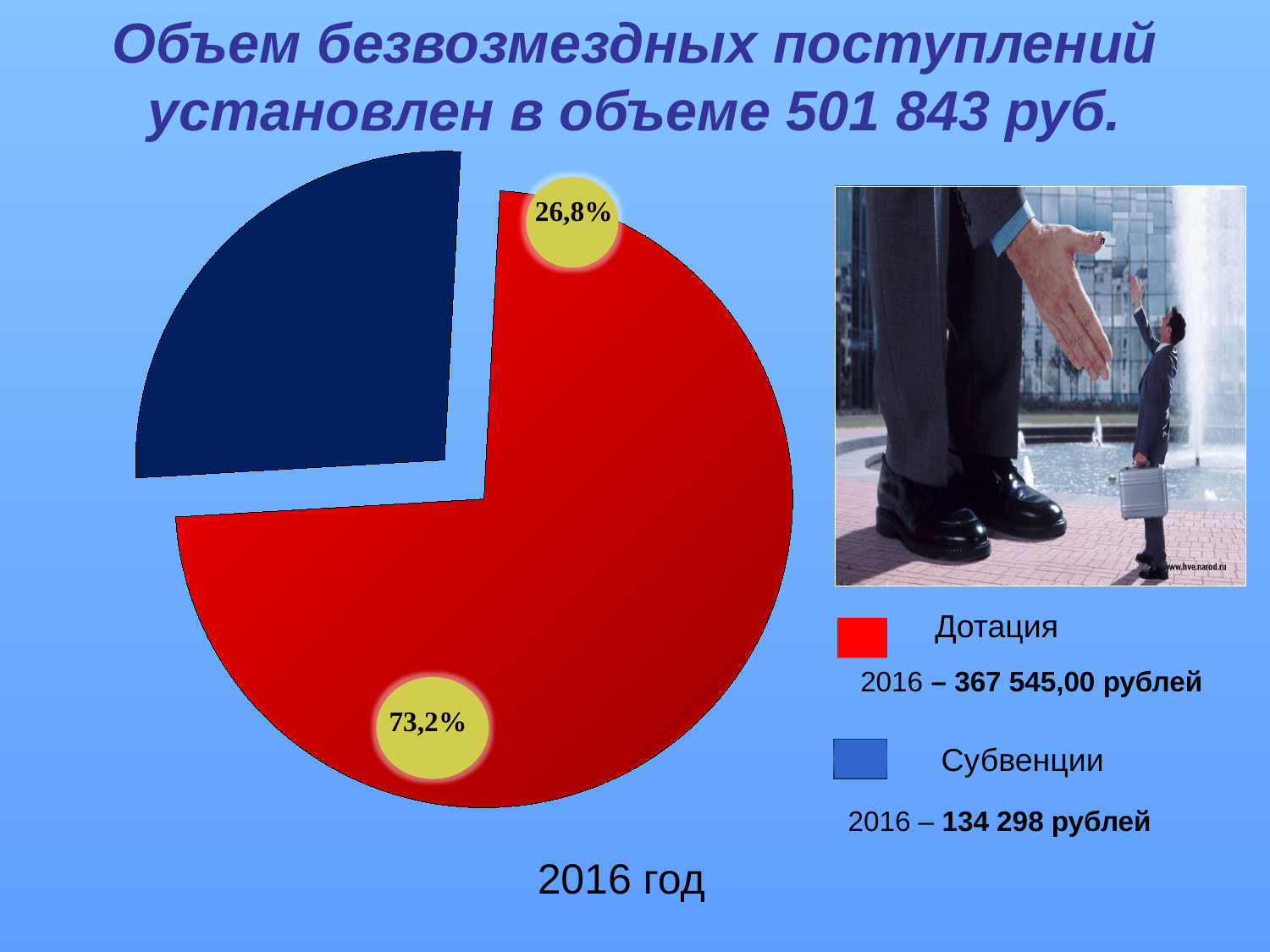
Which category has the largest slice of the pie? Дотация Which category has the smallest slice of the pie? Субвенции What amount in rubles is given for Дотация in 2016? 367 545,00 рублей What colour is the Субвенции slice in the pie chart? blue What amount in rubles is given for Субвенции in 2016? 134 298 рублей Which is larger, the share for Дотация or the share for Субвенции? Дотация What share of the pie does Дотация take? 73,2% What total volume of безвозмездные поступления is stated in the slide title? 501 843 руб. What is the difference in percentage points between the Дотация share and the Субвенции share? 46,4% What share of the pie does Субвенции take? 26,8% How many slices does the pie chart have? 2 What kind of chart is shown on the slide? pie chart